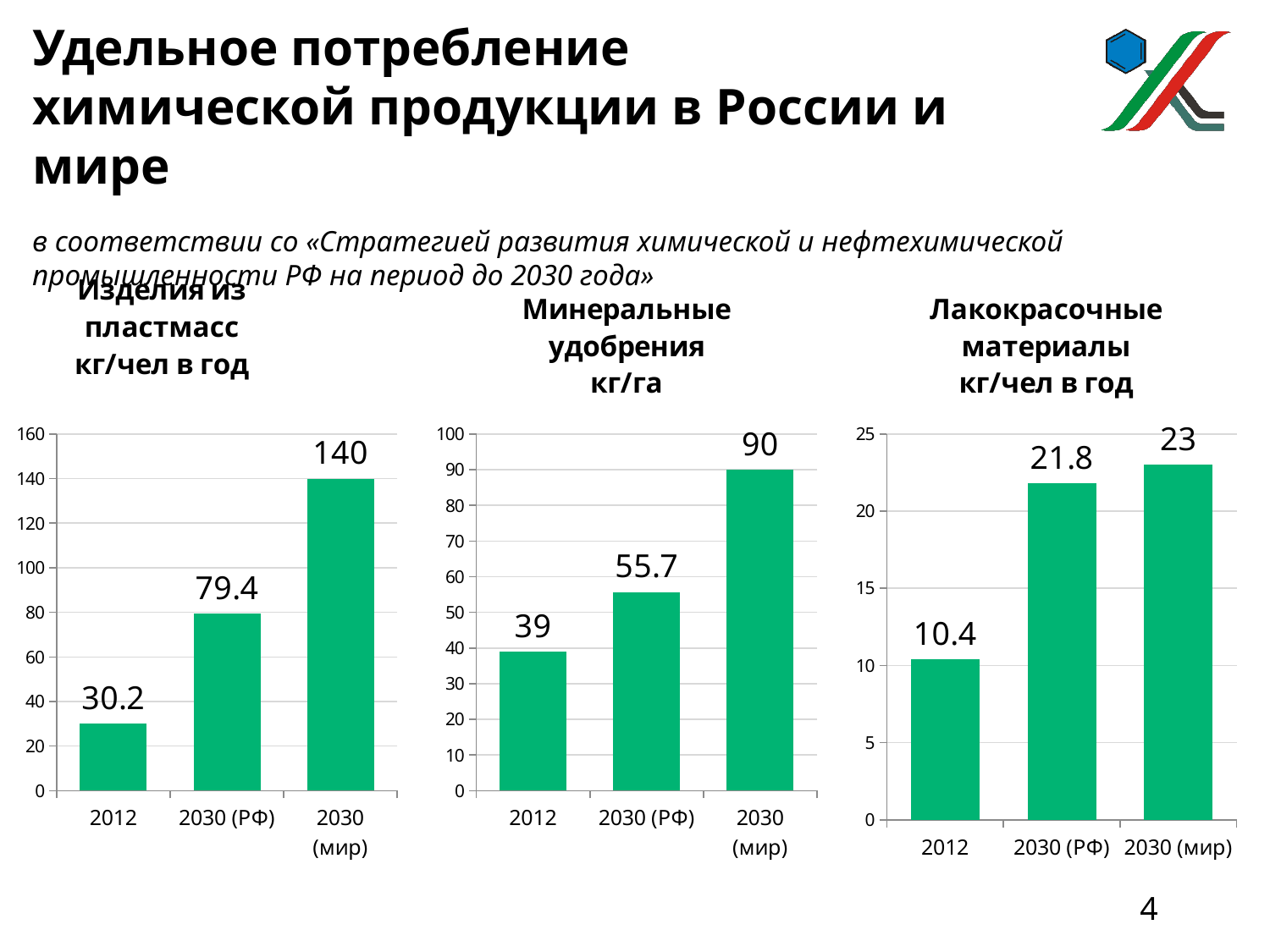
In the right chart (Лакокрасочные материалы), do the values rise or fall from 2012 to 2030 (мир)? Rise In the left chart (Изделия из пластмасс), what is the value for 2030 (мир)? 140 In the left chart (Изделия из пластмасс), what is the value for 2012? 30.2 In the right chart (Лакокрасочные материалы), which category has the highest value? 2030 (мир) In the left chart (Изделия из пластмасс), what is the difference between the 2030 (мир) and 2030 (РФ) values? 60.6 In the right chart (Лакокрасочные материалы), what is the value for 2012? 10.4 In the right chart (Лакокрасочные материалы), which is larger: the value for 2030 (РФ) or 2030 (мир)? 2030 (мир) What type of chart is the left chart (Изделия из пластмасс)? Bar chart In the middle chart (Минеральные удобрения), what is the difference between the 2030 (мир) and 2012 values? 51 In the middle chart (Минеральные удобрения), what is the value for 2030 (РФ)? 55.7 How many bars are plotted in the middle chart (Минеральные удобрения)? 3 In the middle chart (Минеральные удобрения), which category has the lowest value? 2012